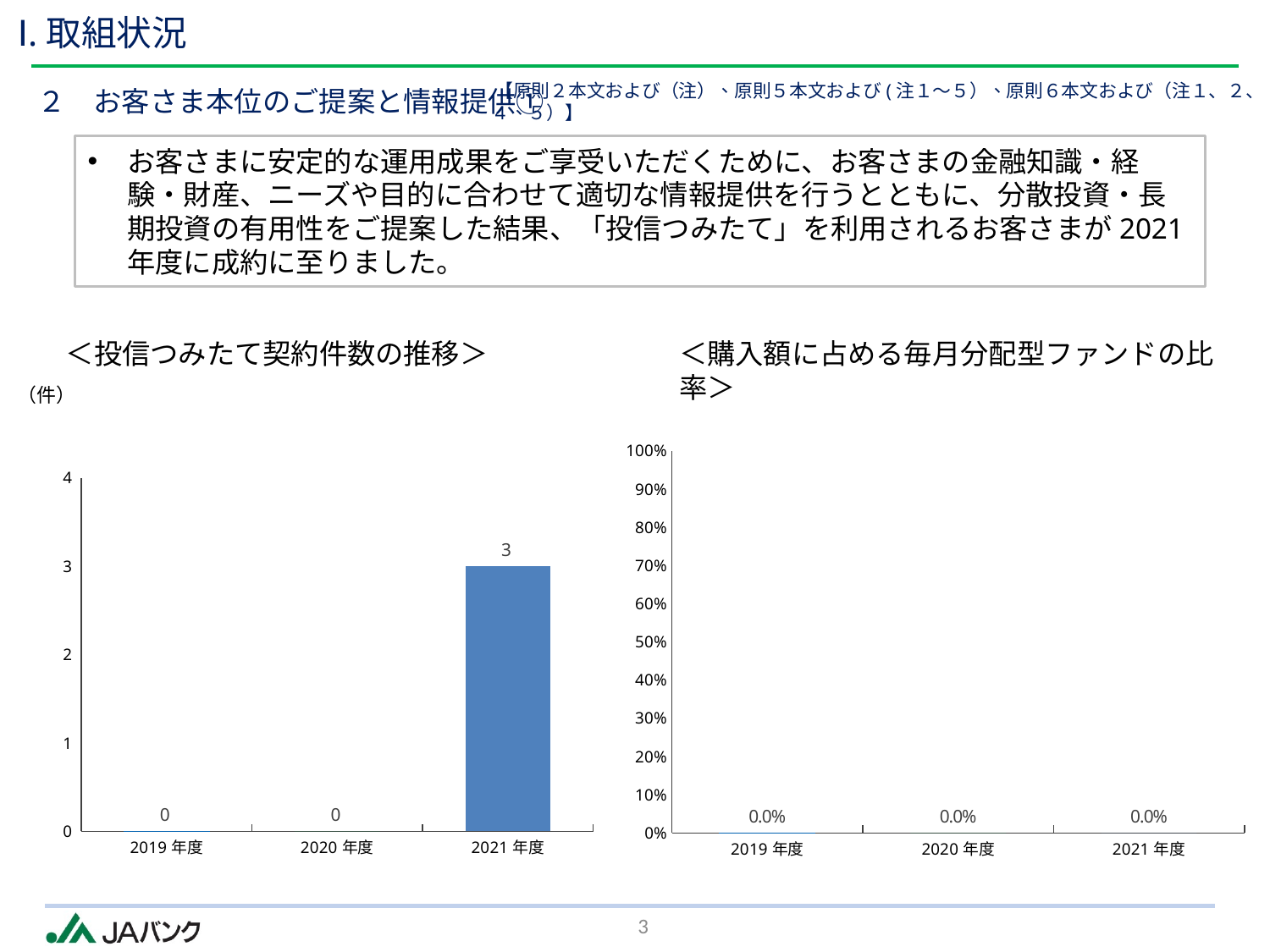
What kind of chart is the left chart (投信つみたて契約件数の推移)? Bar chart In the right chart (購入額に占める毎月分配型ファンドの比率), what is the value for 2021年度? 0.0% In the left chart (投信つみたて契約件数の推移), what is the value for 2019年度? 0 In the left chart (投信つみたて契約件数の推移), what is the value for 2020年度? 0 In the left chart (投信つみたて契約件数の推移), what is the difference between the values for 2021年度 and 2020年度? 3 In the left chart (投信つみたて契約件数の推移), which year has the highest value? 2021年度 In the left chart (投信つみたて契約件数の推移), what unit is shown above the vertical axis? 件 In the right chart (購入額に占める毎月分配型ファンドの比率), what is the value for 2019年度? 0.0% In the left chart (投信つみたて契約件数の推移), which is larger, the value for 2021年度 or the value for 2019年度? 2021年度 In the right chart (購入額に占める毎月分配型ファンドの比率), what is the highest value shown on the vertical axis? 100% In the left chart (投信つみたて契約件数の推移), how many years are shown on the x axis? 3 In the left chart (投信つみたて契約件数の推移), what is the value for 2021年度? 3